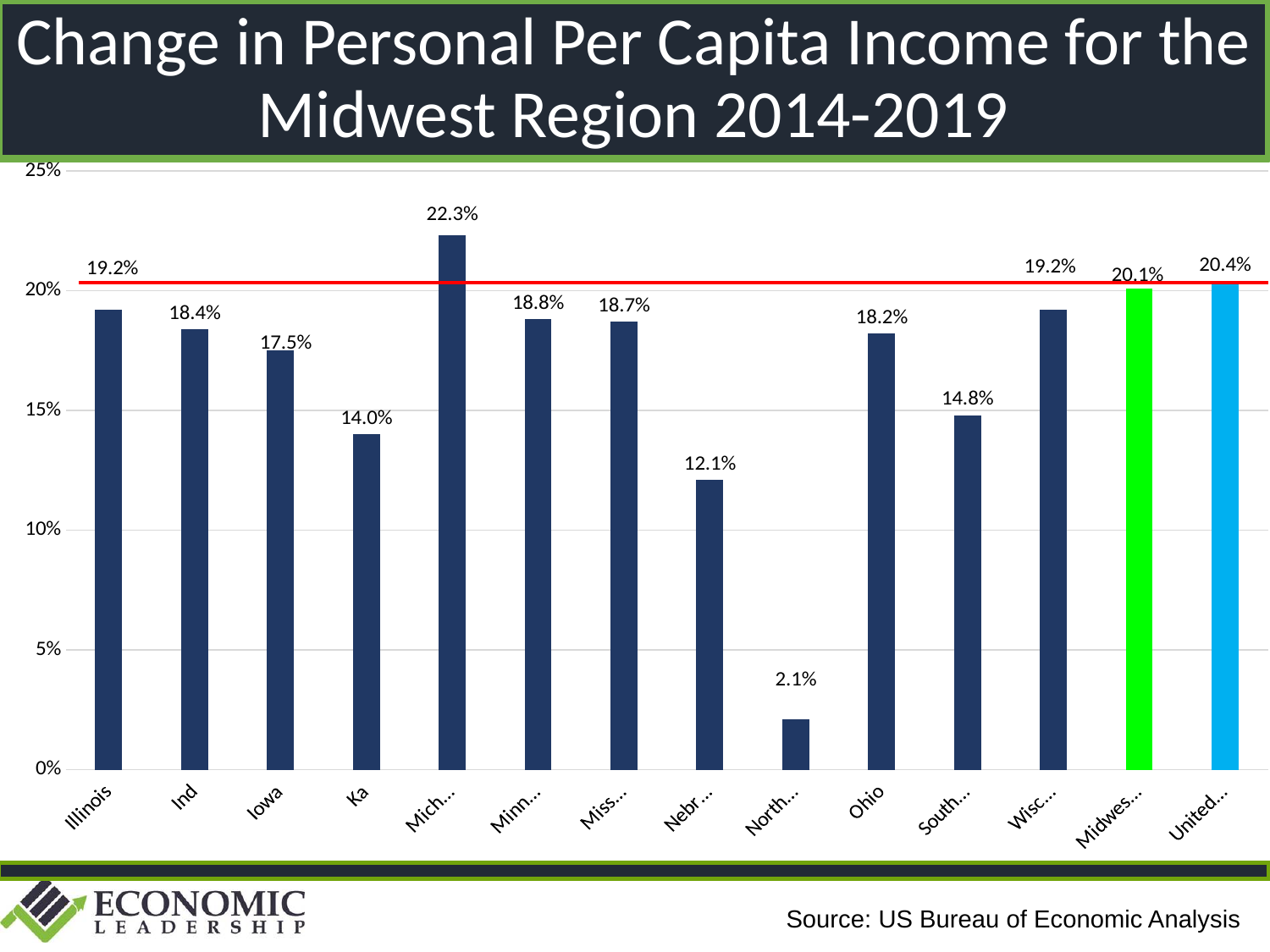
What is the value for Illinois? 19.2% How many bars are shown in the chart? 14 What kind of chart is shown on the slide? bar chart What is the difference between the values for Illinois and Ohio? 1.0% What is the value for the bar labelled "Ka"? 14.0% What is the value for Ohio? 18.2% Which category has the highest value? Mich… Is the value for Ohio greater or less than 15%? greater Which category has the lowest value? North… What colour is the bar labelled "Midwes…"? green What is the value for Iowa? 17.5% Which is larger, the value for Illinois or the value for Iowa? Illinois